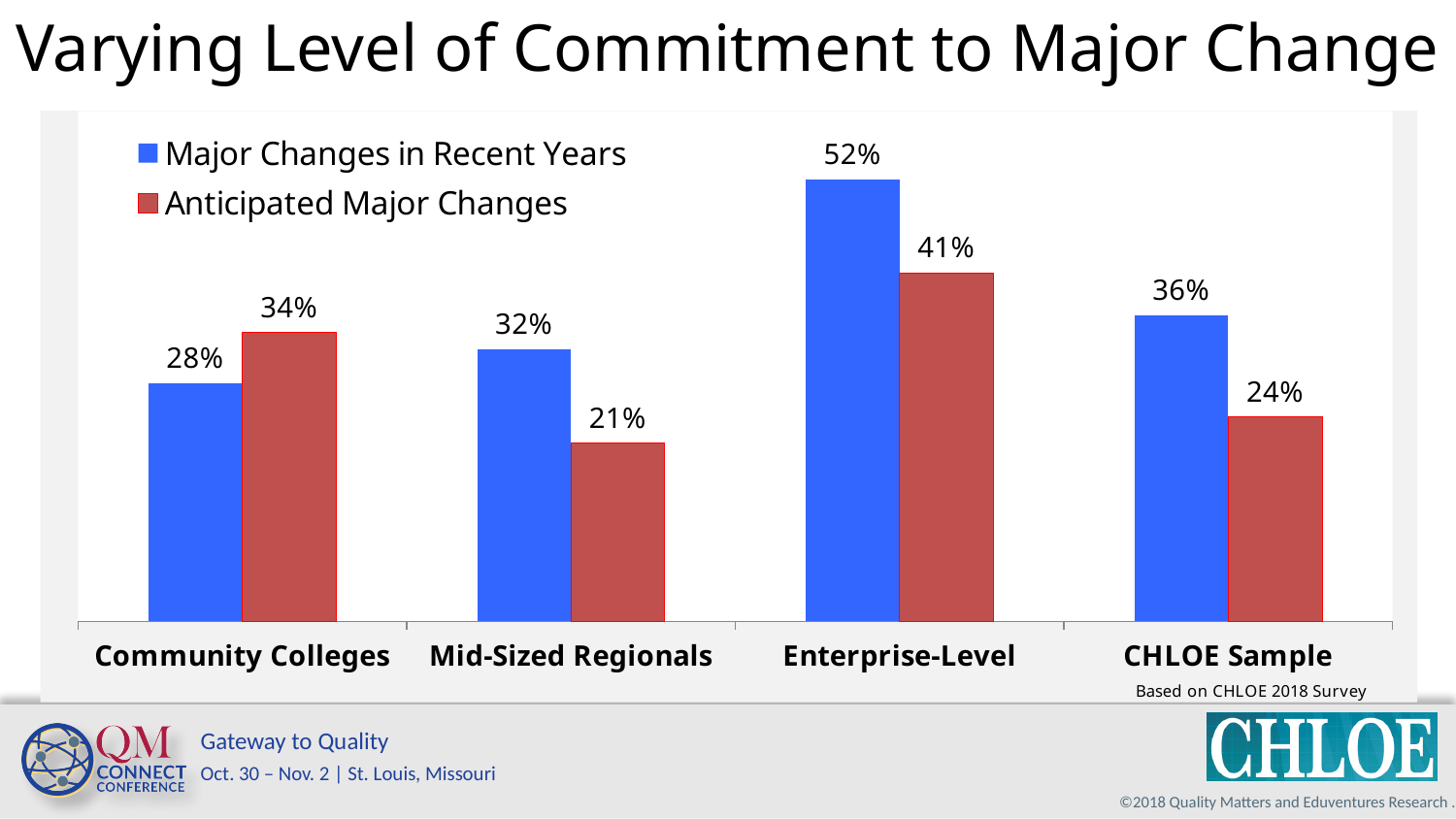
Which category has the highest value for Major Changes in Recent Years? Enterprise-Level Which category has the lowest value for Anticipated Major Changes? Mid-Sized Regionals For Community Colleges, which is larger: Major Changes in Recent Years or Anticipated Major Changes? Anticipated Major Changes What is the value for Major Changes in Recent Years for CHLOE Sample? 36% How many categories are shown on the x axis? 4 What kind of chart is shown on the slide? Bar chart What is the value for Major Changes in Recent Years for Community Colleges? 28% What is the difference between Major Changes in Recent Years and Anticipated Major Changes for Enterprise-Level? 11% What is the value for Anticipated Major Changes for Enterprise-Level? 41% What is the value for Anticipated Major Changes for Mid-Sized Regionals? 21% What colour are the bars for Anticipated Major Changes? Red How many series does the legend list? 2